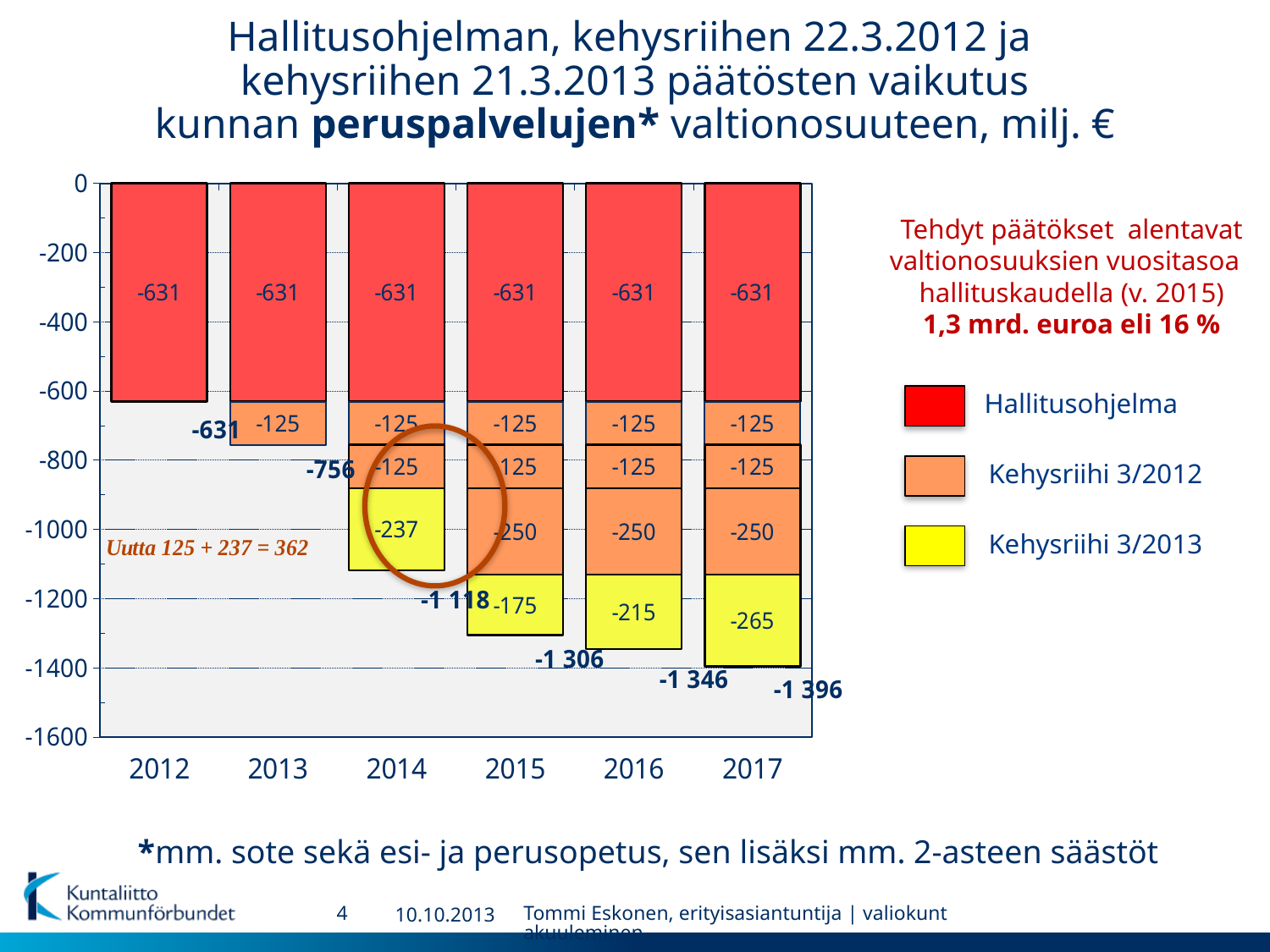
Which year has the larger Kehysriihi 3/2013 reduction, 2014 or 2016? 2014 What is the Hallitusohjelma value for 2015? -631 What is the total of the stacked bar for 2017? -1 396 What kind of chart is shown on the slide? Stacked bar chart Which colour represents Kehysriihi 3/2013 in the legend? Yellow Do the total reductions grow or shrink from 2012 to 2017? Grow What is the Kehysriihi 3/2013 value for 2016? -215 What is the Kehysriihi 3/2013 value for 2014? -237 What is the total of the stacked bar for 2014? -1 118 How many years are shown on the x axis of the chart? 6 How many series does the chart legend list? 3 What is the difference between the Kehysriihi 3/2013 values for 2017 and 2015? 90